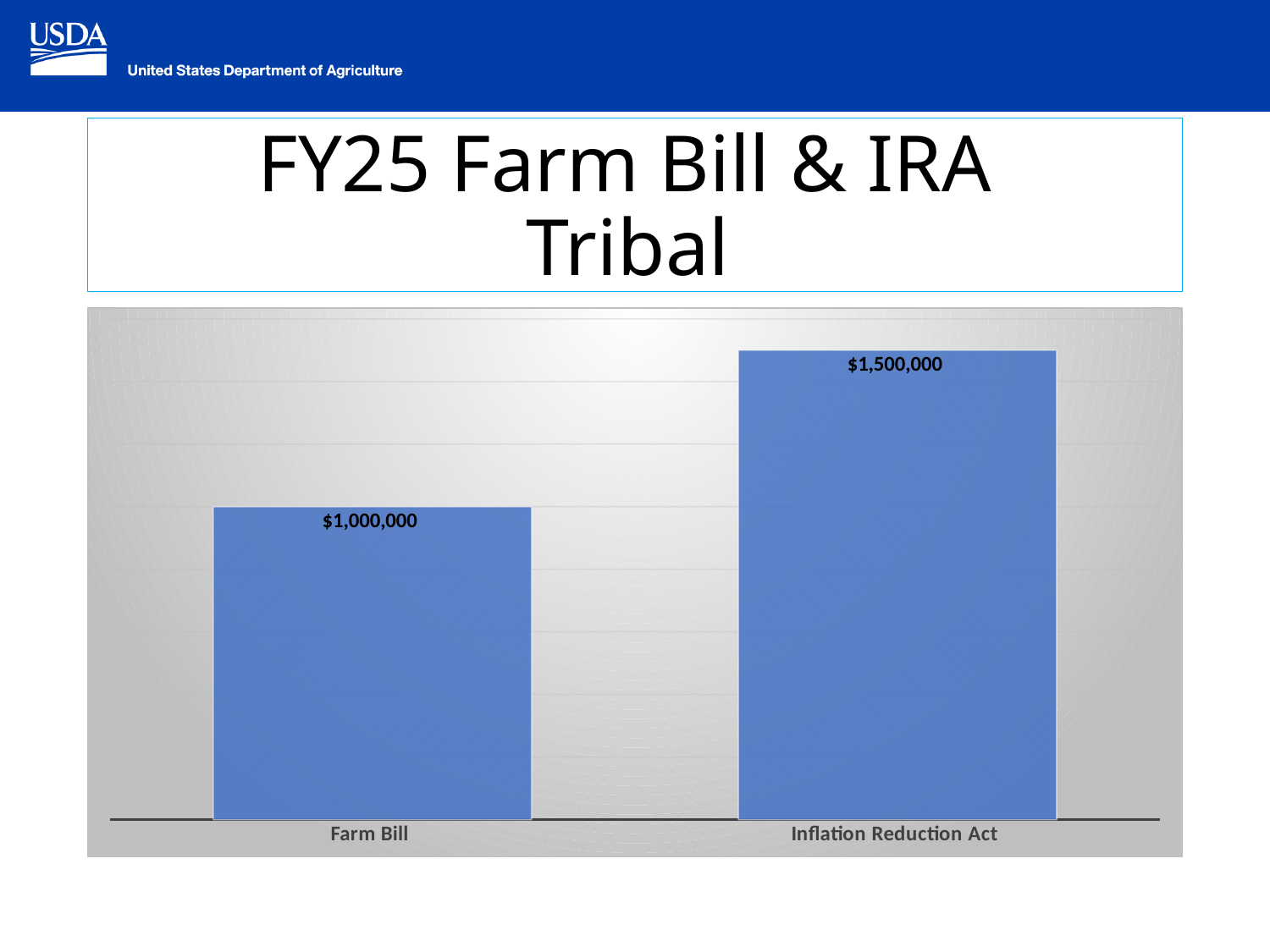
Which category has the highest value? Inflation Reduction Act What is the value for Inflation Reduction Act? $1,500,000 What is the total of the two values shown in the chart? $2,500,000 Which category has the lowest value? Farm Bill What is the title of the slide containing the chart? FY25 Farm Bill & IRA Tribal What kind of chart is shown on the slide? Bar chart How many categories are shown in the chart? 2 What colour are the bars in the chart? Blue What is the value for Farm Bill? $1,000,000 Which is larger, the value for Farm Bill or the value for Inflation Reduction Act? Inflation Reduction Act What is the difference between the Inflation Reduction Act value and the Farm Bill value? $500,000